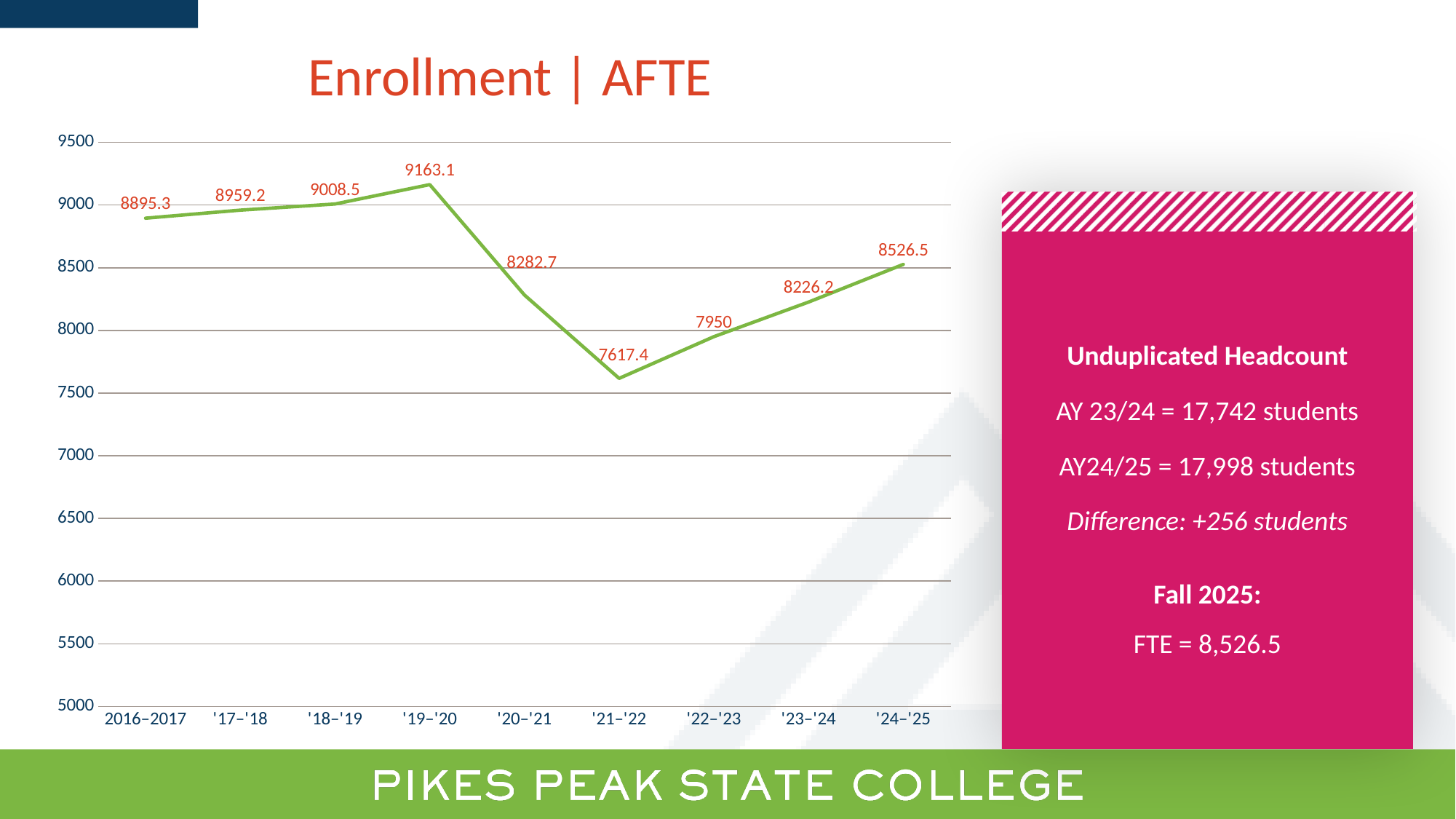
What is the AFTE value for '21–'22? 7617.4 Which academic year has the highest AFTE value? '19–'20 How many academic years are plotted on the chart? 9 What type of chart is shown on the slide? line chart What is the AFTE value for '19–'20? 9163.1 Which is larger, the AFTE value for '20–'21 or for '22–'23? '20–'21 What is the difference between the AFTE values for '19–'20 and '21–'22? 1545.7 Does the AFTE value rise or fall from '21–'22 to '24–'25? rise What is the difference between the AFTE values for '24–'25 and '23–'24? 300.3 Which academic year has the lowest AFTE value? '21–'22 What is the title of the chart? Enrollment | AFTE What is the AFTE value for 2016–2017? 8895.3